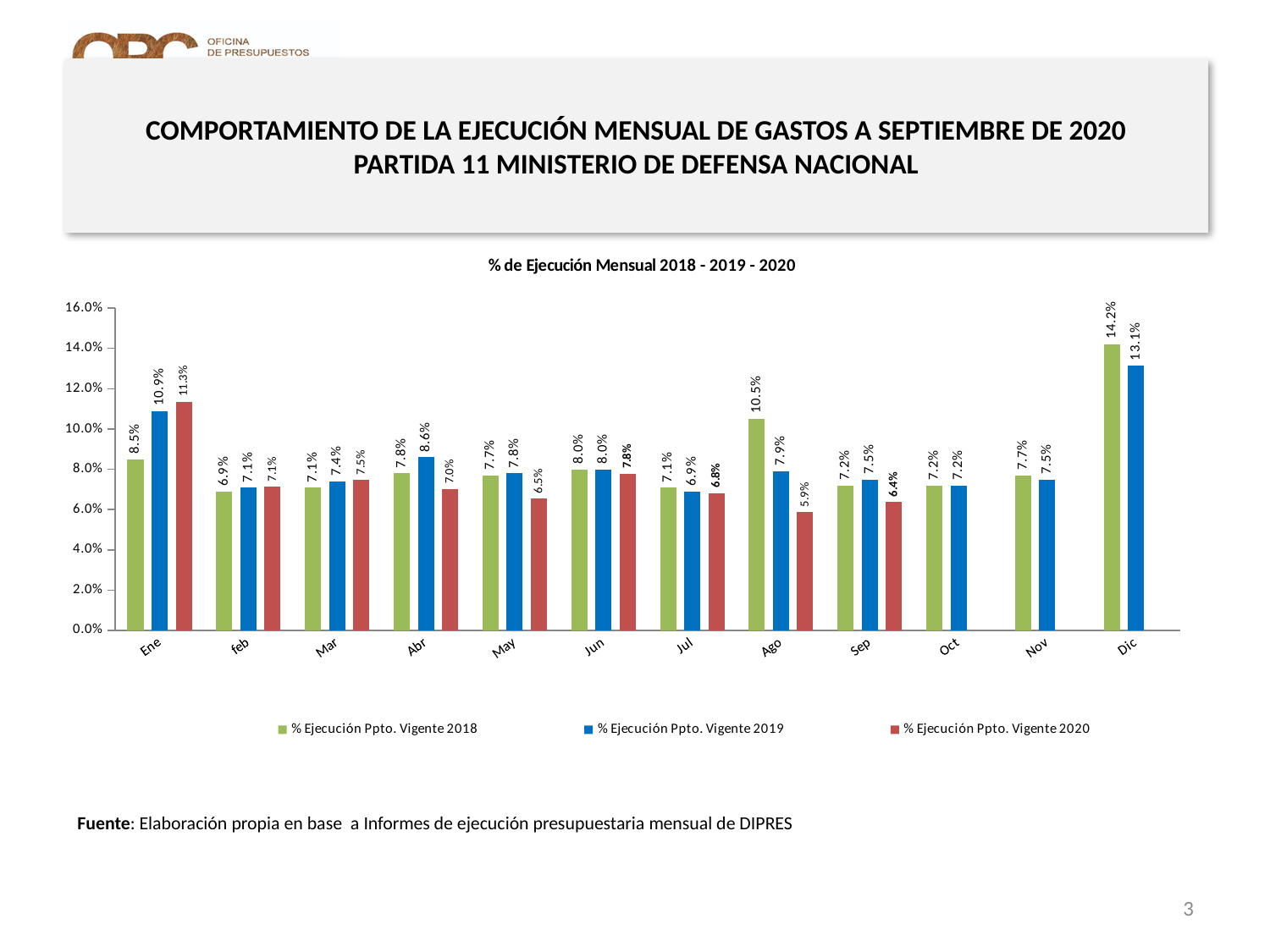
How many series does the legend list? 3 Which month has the lowest value for % Ejecución Ppto. Vigente 2020? Ago Which month has the highest value for % Ejecución Ppto. Vigente 2018? Dic Is the value for % Ejecución Ppto. Vigente 2019 in Ene greater or less than 10.0%? greater Which is larger in Ago: the 2018 value or the 2020 value? 2018 What is the difference between the 2018 and 2019 values in Dic? 1.1% What is the value for % Ejecución Ppto. Vigente 2019 in Abr? 8.6% What kind of chart is shown on the slide? Bar chart How many months are shown on the x axis? 12 What is the value for % Ejecución Ppto. Vigente 2020 in Sep? 6.4% What is the value for % Ejecución Ppto. Vigente 2018 in Ago? 10.5% What is the value for % Ejecución Ppto. Vigente 2020 in Ene? 11.3%